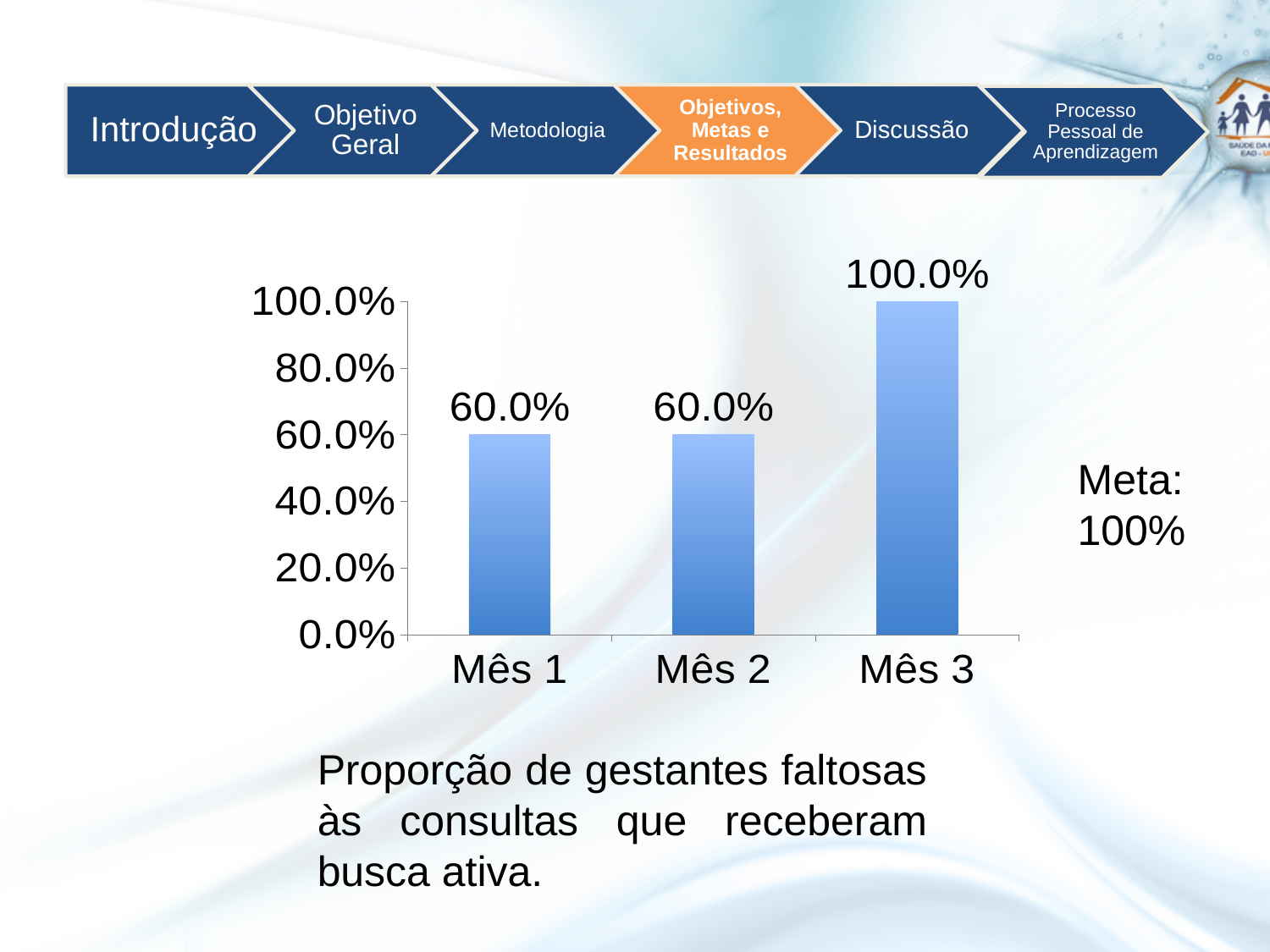
What is the value for Mês 3? 100.0% What is the value for Mês 1? 60.0% Which is larger, the value for Mês 3 or the value for Mês 2? Mês 3 How many months are shown on the x axis? 3 What is the target (Meta) stated next to the chart? 100% What is the value for Mês 2? 60.0% Do the values rise or fall from Mês 2 to Mês 3? rise Is the value for Mês 1 greater or less than 80.0%? less What kind of chart is shown on the slide? bar chart What is the difference between the values for Mês 3 and Mês 1? 40.0% What is the highest value shown on the y axis? 100.0% Which month has the highest value? Mês 3